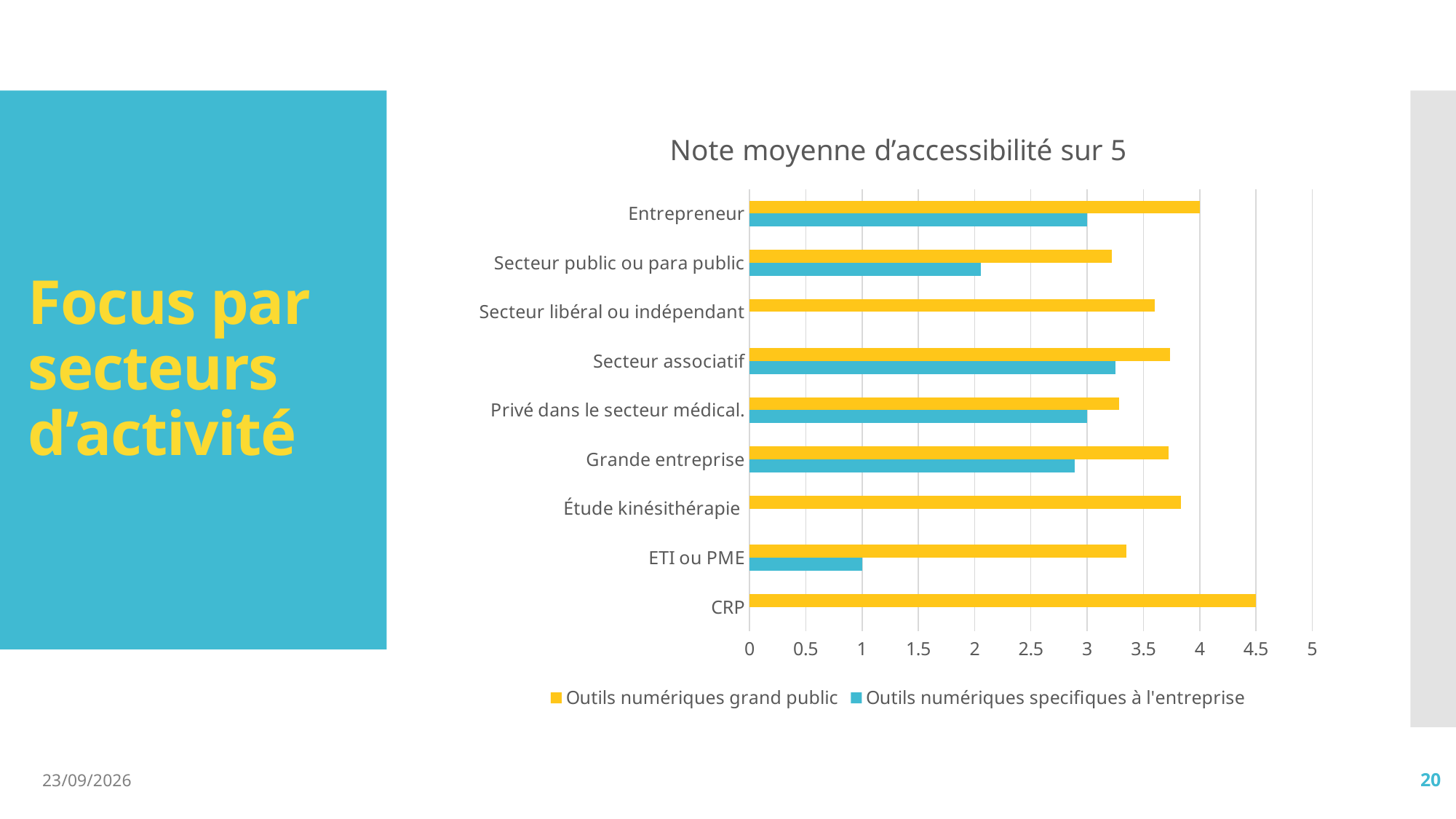
What is the value for CRP in the 'Outils numériques grand public' series? 4.5 Is the 'Outils numériques grand public' value for Étude kinésithérapie greater or less than 3.5? greater What is the difference between the 'Outils numériques grand public' and 'Outils numériques specifiques à l'entreprise' values for Entrepreneur? 1 Which category has the highest value in the 'Outils numériques grand public' series? CRP What kind of chart is shown on the slide? bar chart What is the title of the chart? Note moyenne d'accessibilité sur 5 What is the value for Entrepreneur in the 'Outils numériques grand public' series? 4 Is the 'Outils numériques specifiques à l'entreprise' value for Secteur public ou para public greater or less than 2.5? less What is the value for ETI ou PME in the 'Outils numériques specifiques à l'entreprise' series? 1 How many series does the legend list? 2 How many sector categories are shown on the y axis? 9 Which category has the lowest value in the 'Outils numériques specifiques à l'entreprise' series? ETI ou PME